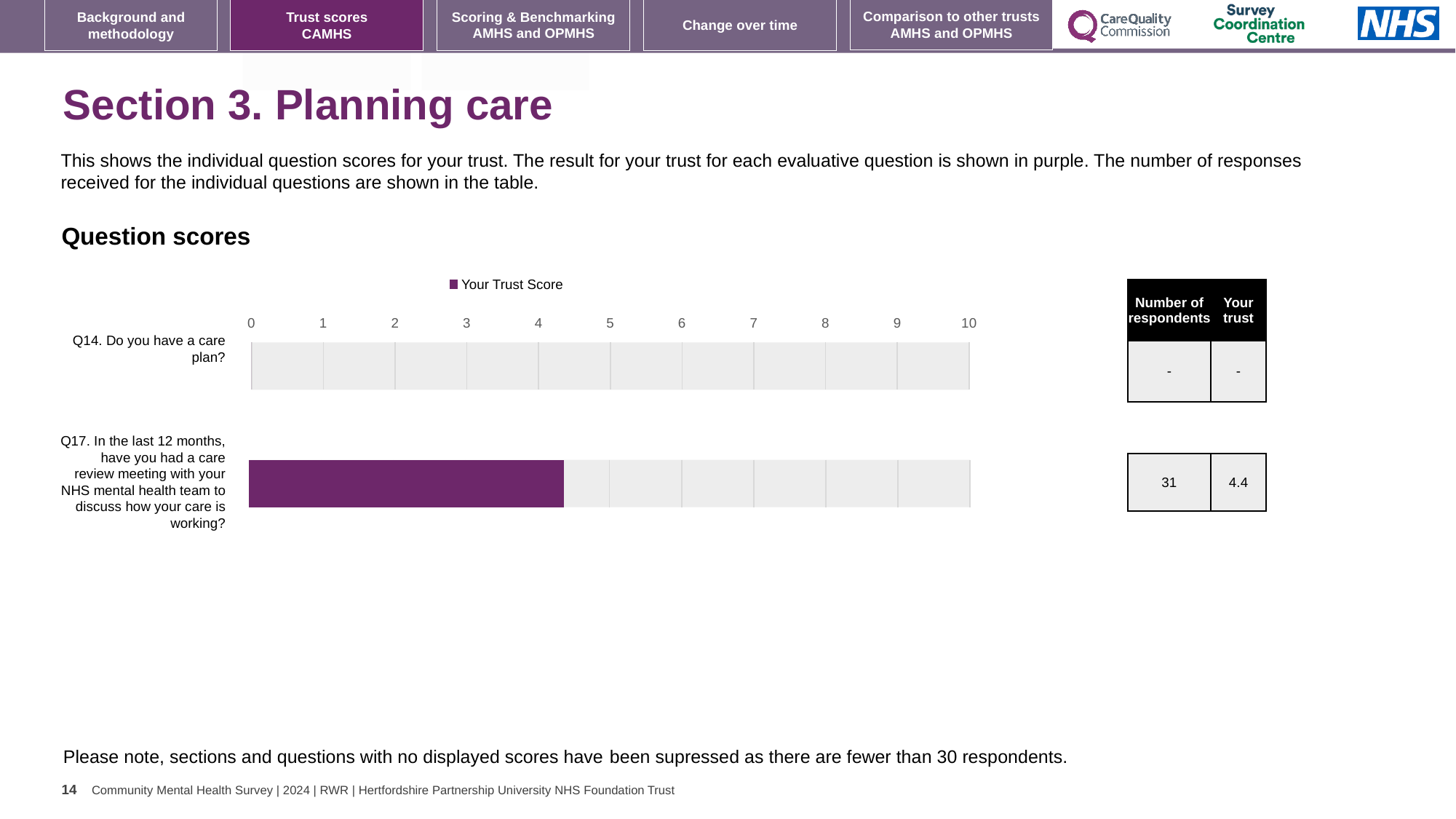
What is the name of the series shown in the chart legend? Your Trust Score What type of chart is shown under 'Question scores'? bar chart How many series does the chart legend list? 1 What is shown in the table for the number of respondents for Q14 (Do you have a care plan?)? - What is the maximum value shown on the chart's axis? 10 What is the trust score for Q17 (care review meeting in the last 12 months)? 4.4 Which question has a plotted bar on the chart, Q14 or Q17? Q17 Is the value for Q17 greater or less than 5? less How many respondents answered Q17 according to the table? 31 Is the value for Q17 greater or less than 4? greater How many questions (categories) are shown on the chart? 2